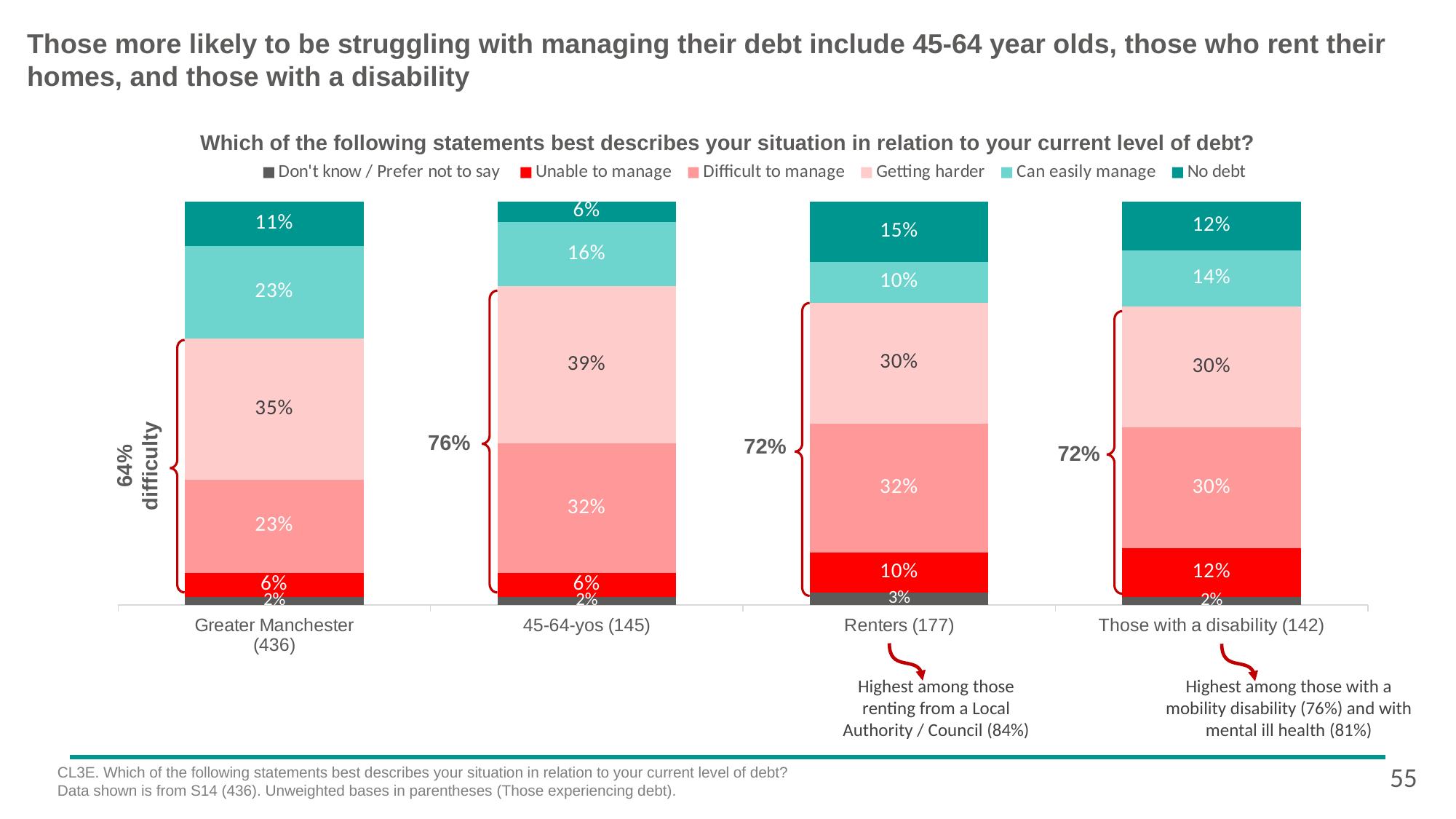
What percentage of Renters (177) are 'Unable to manage' their debt? 10% Which category has the highest 'Unable to manage' percentage? Those with a disability (142) Which is larger: the 'Difficult to manage' value for Renters (177) or for Those with a disability (142)? Renters (177) Which category has the lowest 'No debt' percentage? 45-64-yos (145) What is the difference between the 'Getting harder' values for 45-64-yos (145) and Greater Manchester (436)? 4 percentage points What is the 'Can easily manage' value for Those with a disability (142)? 14% What total 'difficulty' percentage is bracketed for the 45-64-yos (145) bar? 76% How many categories are shown on the x axis? 4 How many series does the legend list? 6 What is the 'No debt' value for Greater Manchester (436)? 11% What kind of chart is shown on the slide? Stacked bar chart What is the 'Getting harder' value for 45-64-yos (145)? 39%